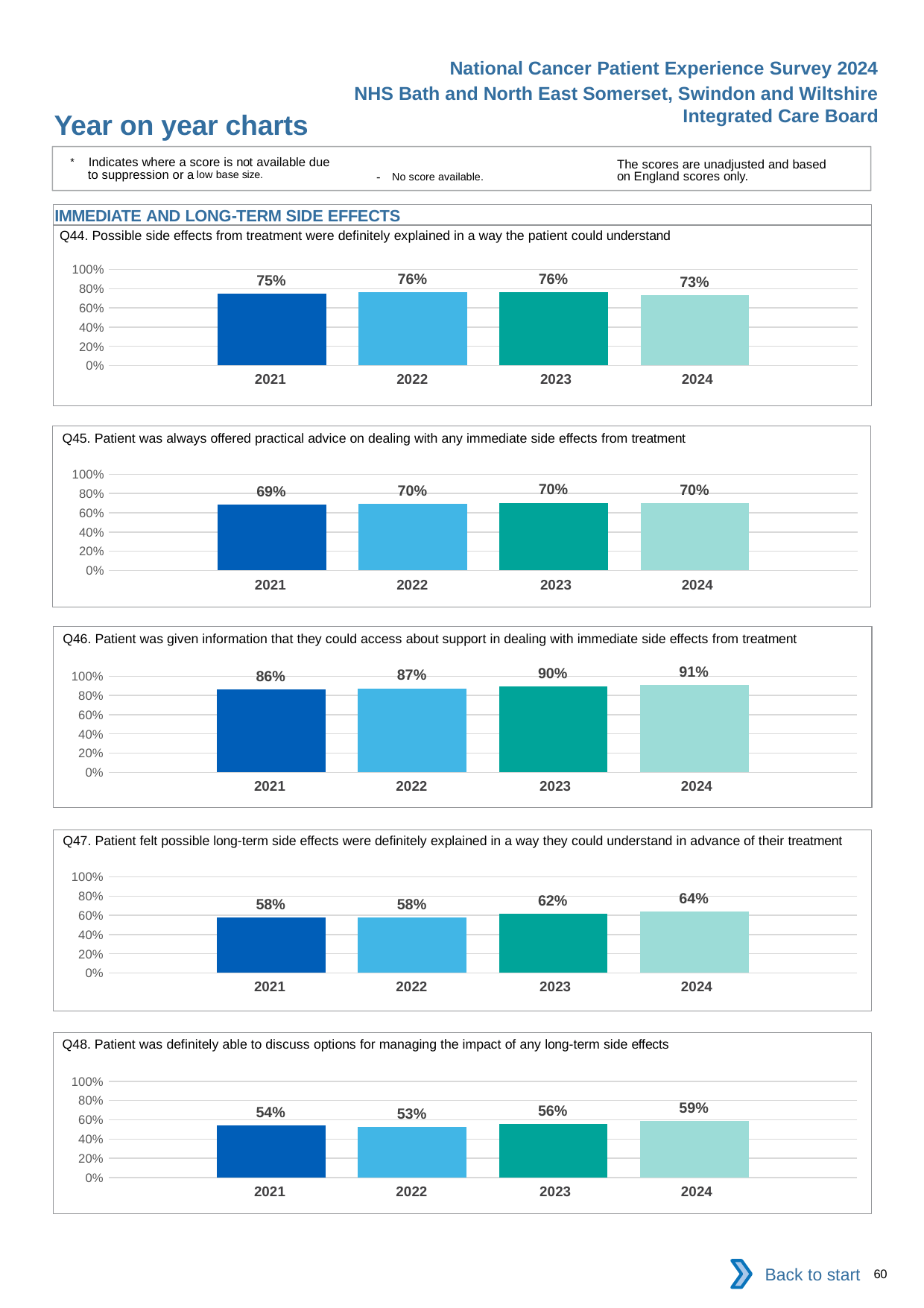
In the Q46 chart, what is the difference between the 2024 and 2021 values? 5 percentage points In the Q47 chart, what is the value for 2023? 62% In the Q45 chart, which year has the lowest value? 2021 In the Q46 chart, which year has the highest value? 2024 In the Q48 chart, which is larger, the value for 2022 or the value for 2024? 2024 In the Q48 chart, is the value for 2022 greater or less than 60%? less In the Q44 chart, what is the value for 2024? 73% In the Q47 chart, is the value for 2024 greater or less than 60%? greater How many years are shown in the Q44 chart? 4 What kind of chart is used for Q45? Bar chart In the Q48 chart, what is the value for 2021? 54% In the Q46 chart, do the values rise or fall from 2021 to 2024? Rise